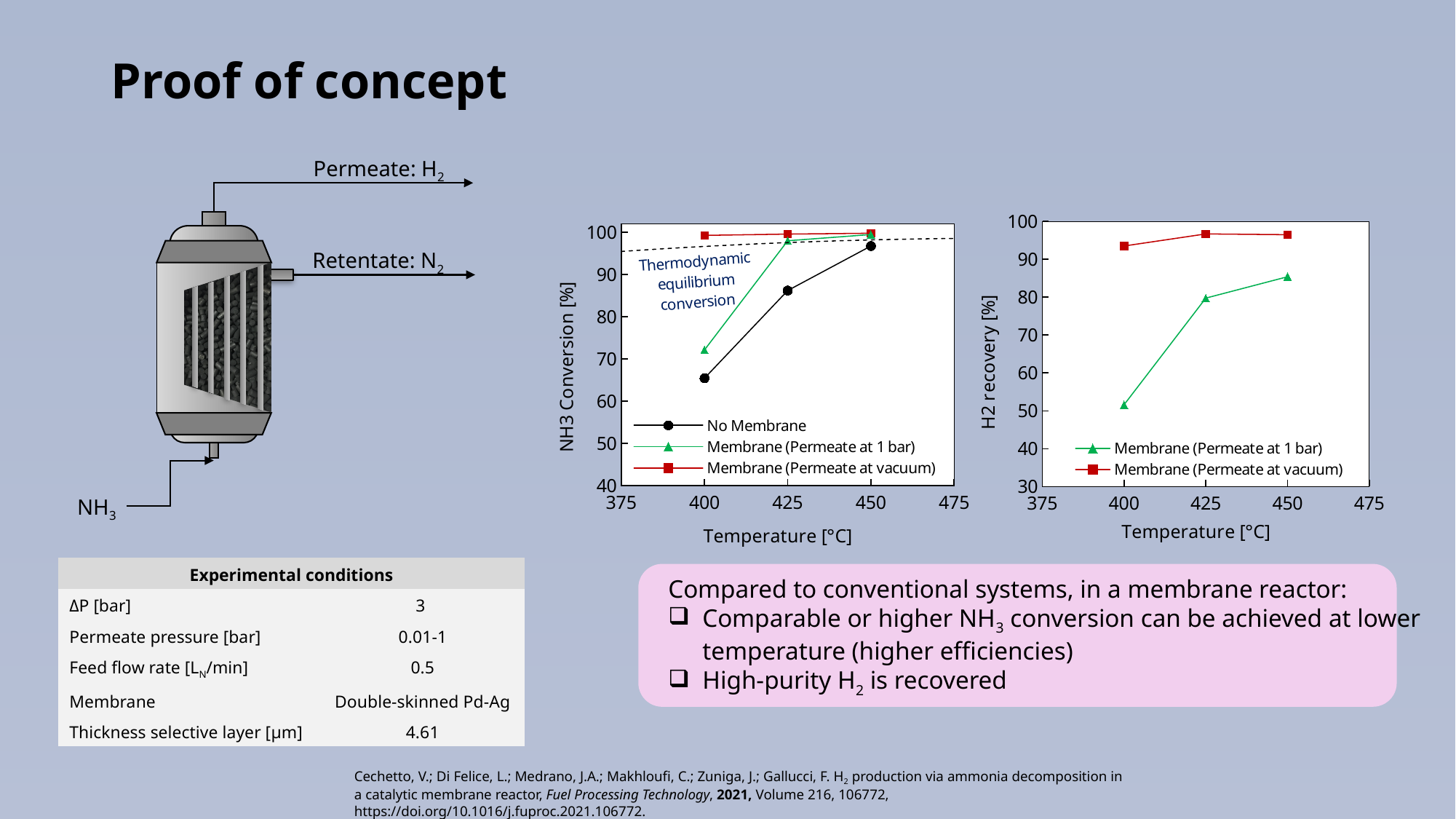
In the NH3 Conversion chart, which series has the lowest value at 400 °C? No Membrane In the NH3 Conversion chart, is the No Membrane value at 400 °C greater or less than 70? less What kind of chart is the NH3 Conversion chart on the left? line chart In the H2 recovery chart, is the Membrane (Permeate at vacuum) value at 400 °C greater or less than 90? greater In the NH3 Conversion chart, is the Membrane (Permeate at 1 bar) value at 400 °C greater or less than 80? less In the H2 recovery chart, how many temperature points are plotted for the Membrane (Permeate at 1 bar) series? 3 In the NH3 Conversion chart, does the No Membrane series rise or fall as temperature increases? rise What does the dashed line in the NH3 Conversion chart represent, according to its label? Thermodynamic equilibrium conversion In the H2 recovery chart, which series has the higher value at 425 °C, Membrane (Permeate at 1 bar) or Membrane (Permeate at vacuum)? Membrane (Permeate at vacuum) How many series does the legend of the NH3 Conversion chart list? 3 How many series does the legend of the H2 recovery chart list? 2